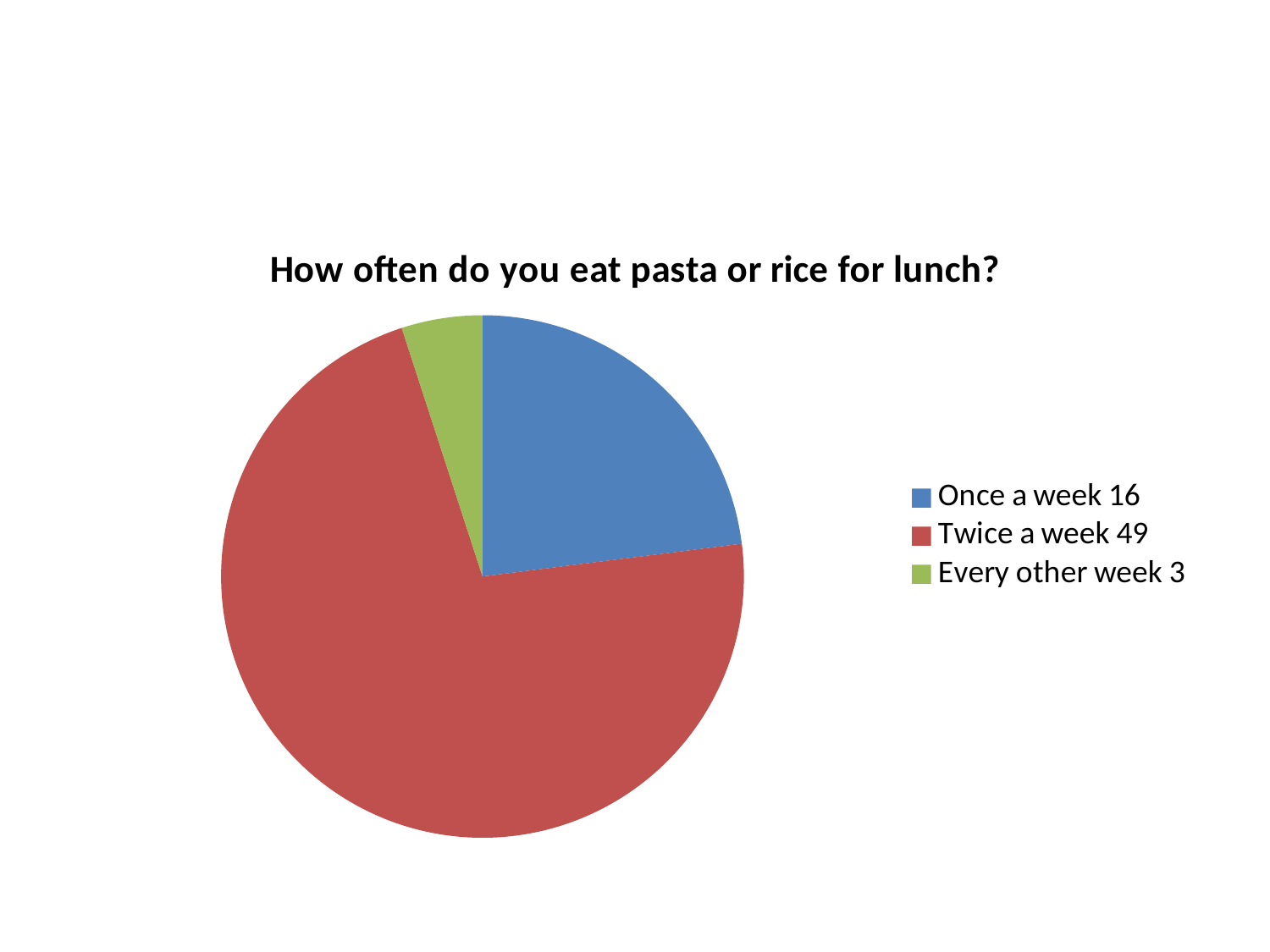
What is the value for "Every other week"? 3 What is the total of all three categories in the pie chart? 68 What is the value for "Twice a week"? 49 Which category has the smallest slice of the pie? Every other week What is the title of the chart? How often do you eat pasta or rice for lunch? What is the value for "Once a week"? 16 What kind of chart is shown on the slide? Pie chart What is the difference between the values for "Twice a week" and "Once a week"? 33 Which category has the largest slice of the pie? Twice a week Which is larger, the value for "Once a week" or the value for "Every other week"? Once a week How many categories does the pie chart have? 3 What colour is the slice for "Twice a week"? Red